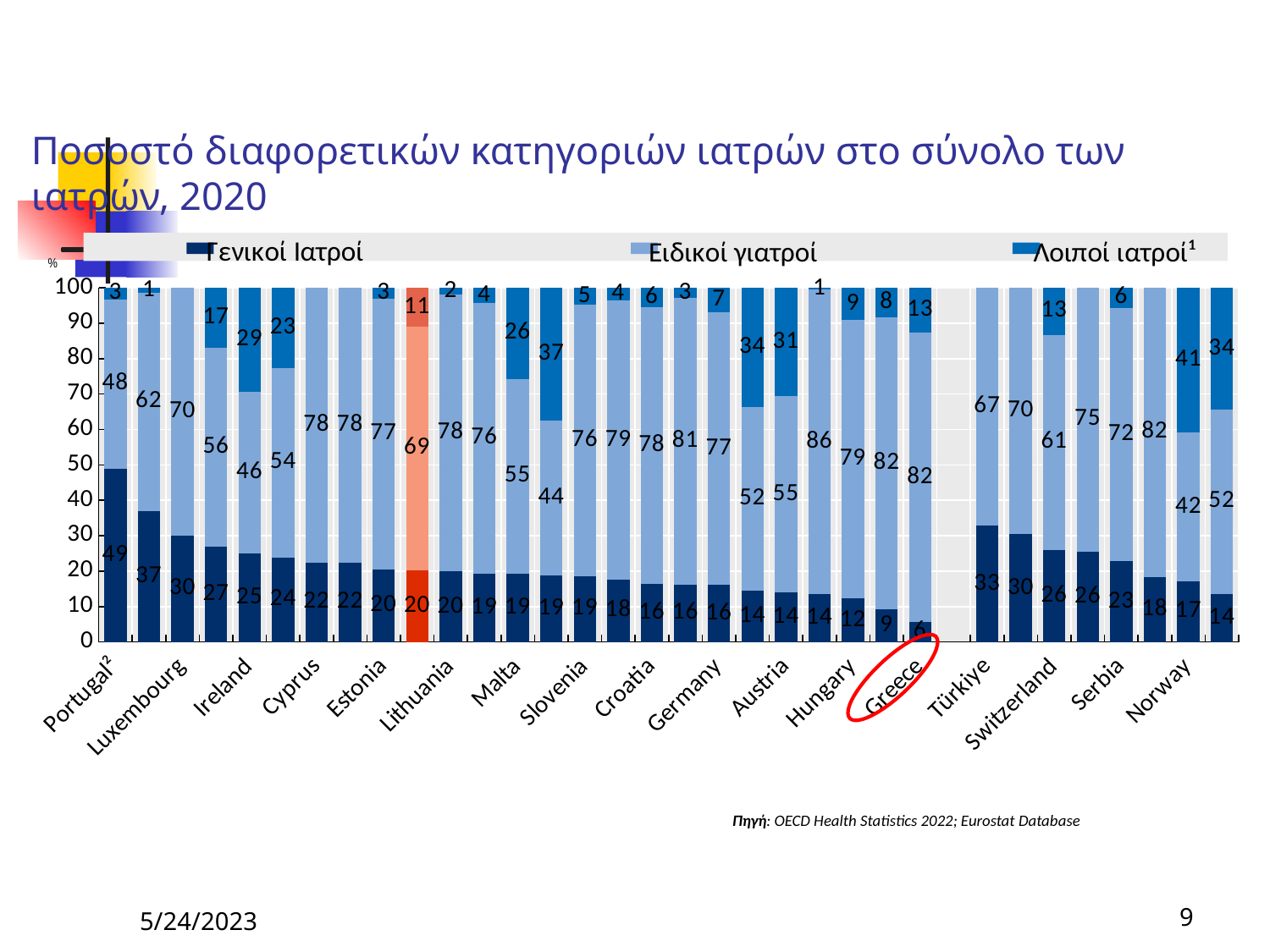
Which country has the highest share of Γενικοί Ιατροί? Portugal Which country is circled in red on the x axis? Greece How many series does the legend list? 3 What is the value of Γενικοί Ιατροί for Türkiye? 33 What is the value of Γενικοί Ιατροί for Greece? 6 What are the three series named in the legend? Γενικοί Ιατροί, Ειδικοί γιατροί, Λοιποί ιατροί Which country has the lowest share of Γενικοί Ιατροί? Greece What is the difference between the Γενικοί Ιατροί value for Portugal and for Greece? 43 What is the value of Ειδικοί γιατροί for Greece? 82 What is the value of Γενικοί Ιατροί for Portugal? 49 What is the value of Λοιποί ιατροί for Greece? 13 What kind of chart is shown on the slide? Stacked bar chart